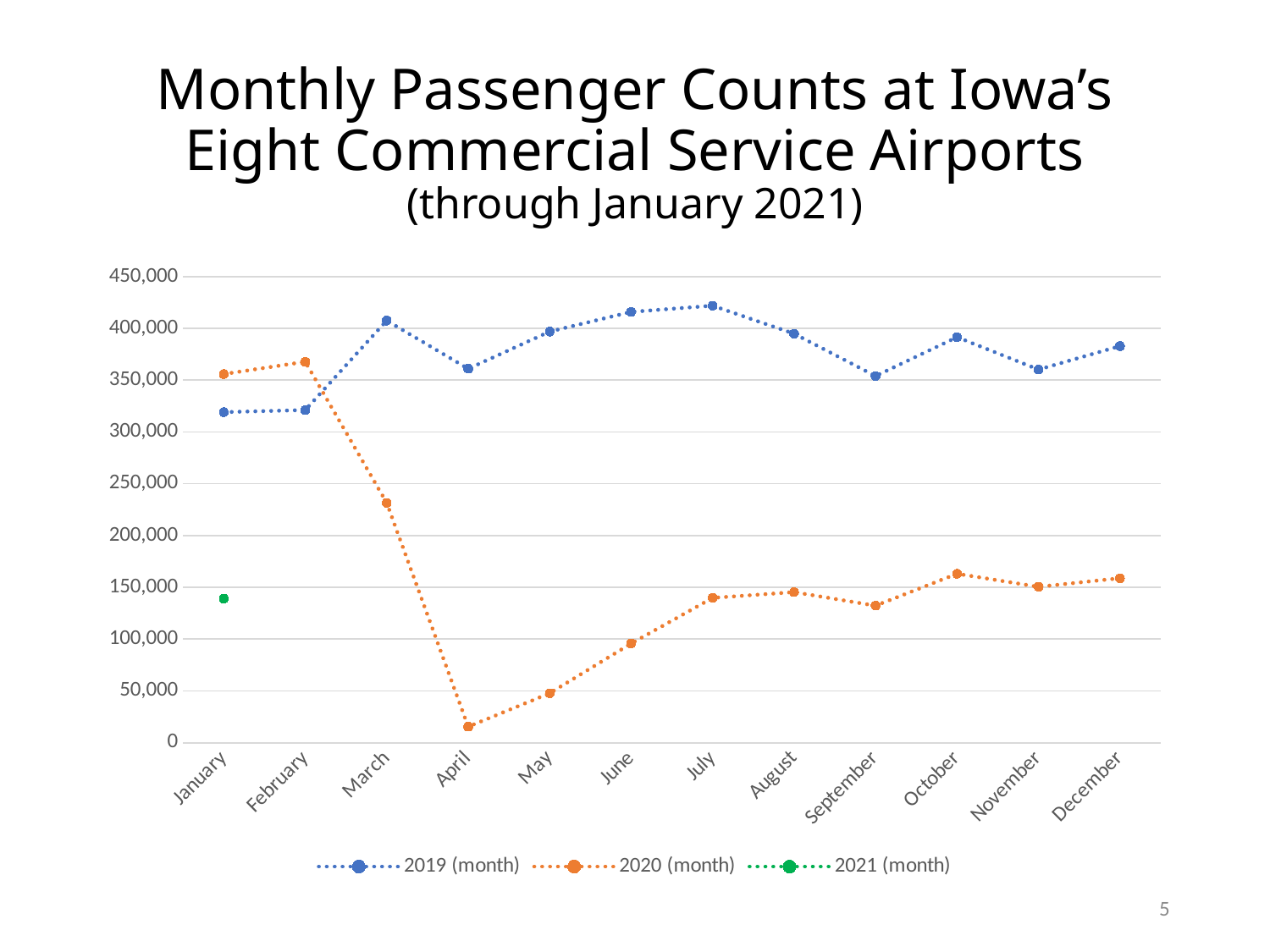
Is the value for April in the 2020 (month) series greater or less than 50,000? less What kind of chart is shown on the slide? line chart Which series has the larger value in March: 2019 (month) or 2020 (month)? 2019 (month) How many months are shown along the x axis? 12 In which month is the 2020 (month) series at its lowest? April Is the value for March in the 2019 (month) series greater or less than 400,000? greater What is the title of the chart? Monthly Passenger Counts at Iowa's Eight Commercial Service Airports (through January 2021) Is the value for March in the 2020 (month) series greater or less than 200,000? greater Which series has the larger value in January: 2019 (month) or 2020 (month)? 2020 (month) Does the 2020 (month) series rise or fall from February to April? fall How many series does the legend list? 3